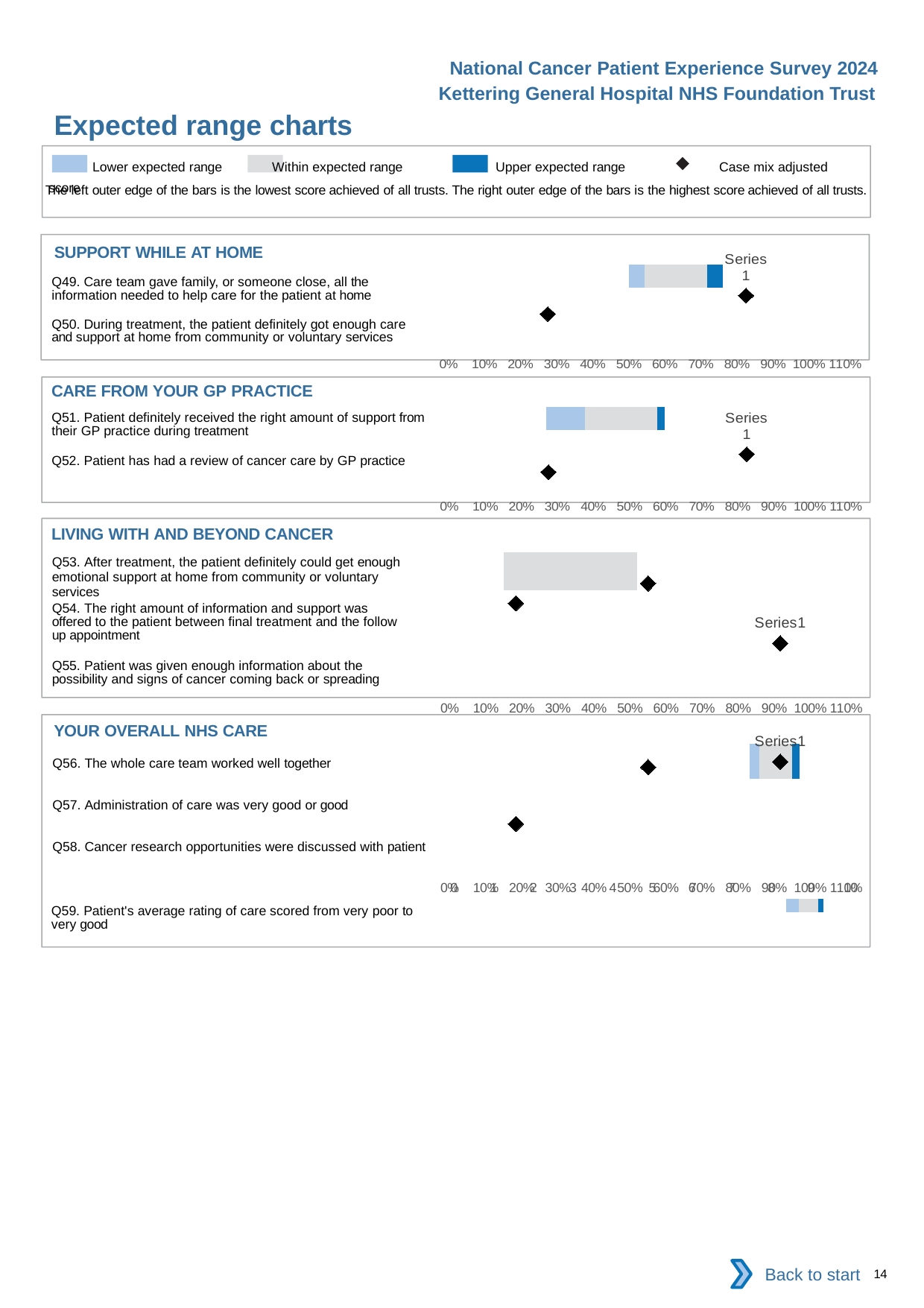
How many entries does the legend at the top of the slide list? 4 What kind of chart is used in the 'SUPPORT WHILE AT HOME' section? bar chart What is the highest tick label shown on the x axis of the 'CARE FROM YOUR GP PRACTICE' chart? 110% How many questions are listed in the 'LIVING WITH AND BEYOND CANCER' section? 3 In the 'LIVING WITH AND BEYOND CANCER' chart, is the right edge of the grey expected range bar greater or less than 40%? greater How many questions are listed in the 'SUPPORT WHILE AT HOME' section? 2 In the 'CARE FROM YOUR GP PRACTICE' chart, is the right edge of the expected range bar greater or less than 50%? greater In the legend, which symbol represents the case mix adjusted score? a black diamond How many questions are listed in the 'YOUR OVERALL NHS CARE' section? 4 In the 'LIVING WITH AND BEYOND CANCER' chart, is the left edge of the grey expected range bar greater or less than 20%? less